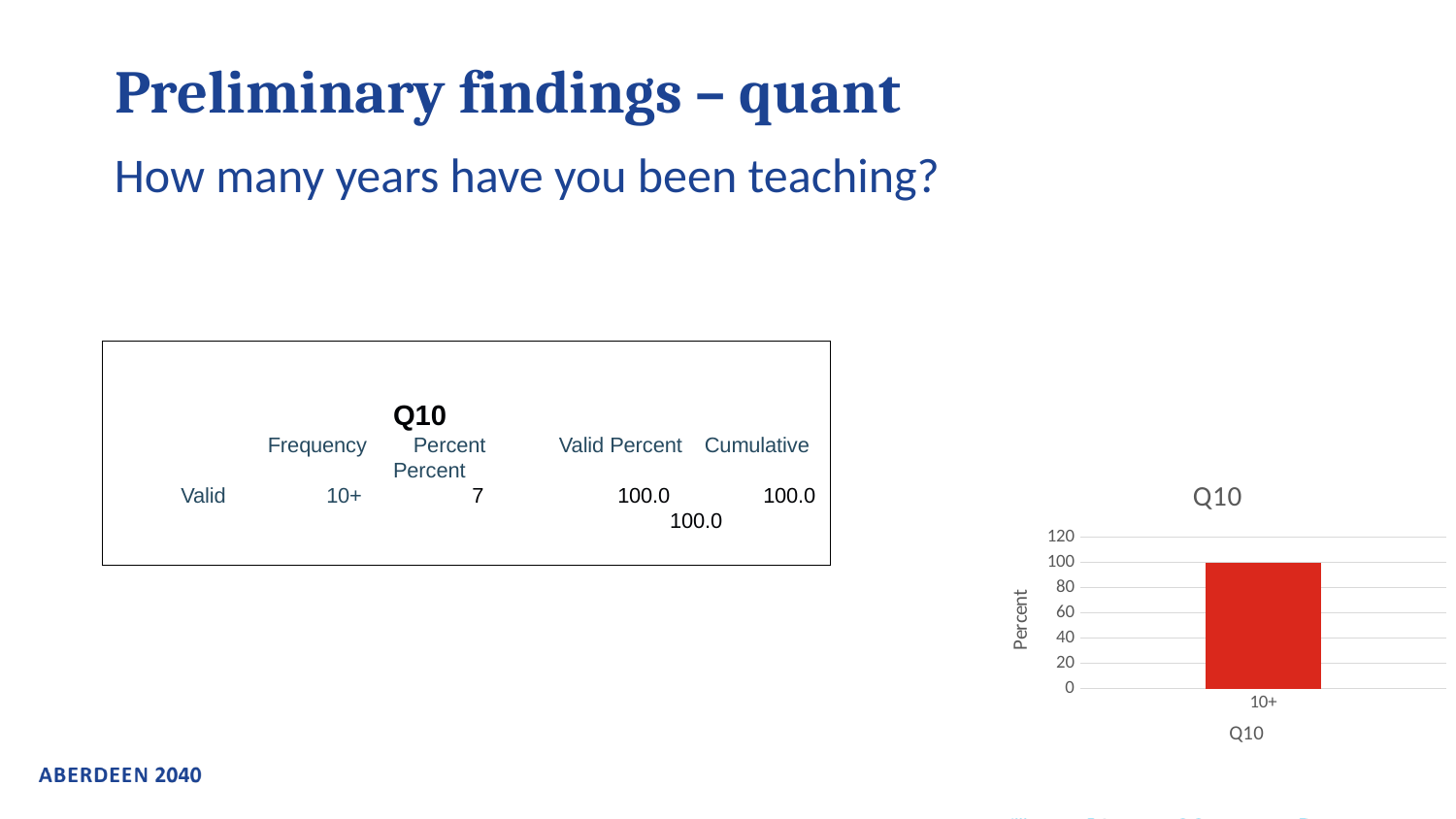
What is the label on the vertical axis of the chart? Percent How many bars does the chart show? 1 Is the value for 10+ greater or less than 120? less Is the value for 10+ greater or less than 80? greater What is the value for the 10+ category in the chart? 100 What kind of chart is shown on the slide? bar chart What is the title of the chart? Q10 What is the label of the only category on the x axis? 10+